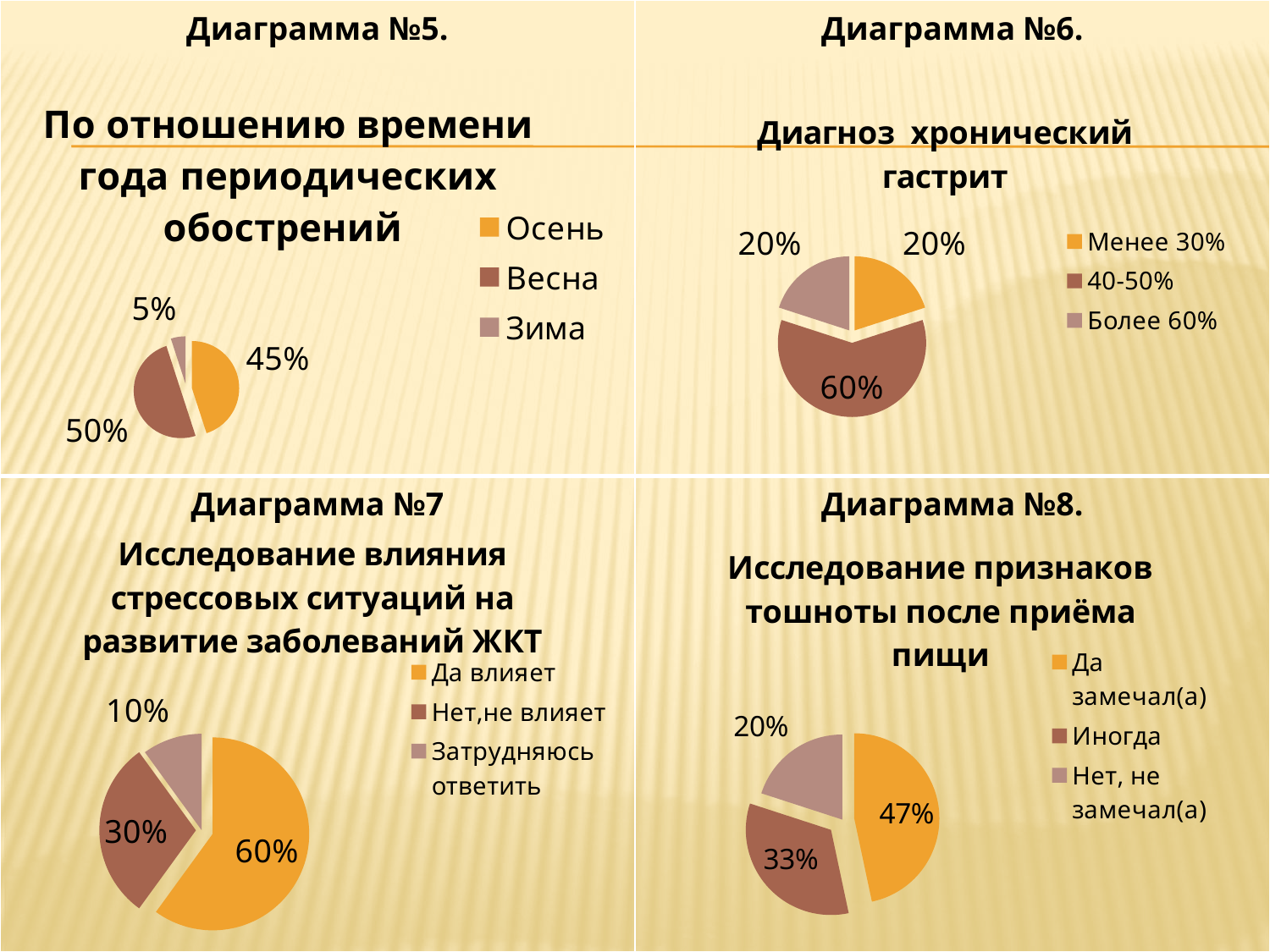
In Диаграмма №5, which category has the smallest slice? Зима In Диаграмма №7, which is larger: Да влияет or Затрудняюсь ответить? Да влияет In Диаграмма №6, what share of the pie is labelled 40-50%? 60% In Диаграмма №7, what is the difference between the Да влияет and Нет,не влияет slices? 30% In Диаграмма №5, what is the difference between the Весна and Осень slices? 5% In Диаграмма №8, which category has the largest slice? Да замечал(а) What type of chart is Диаграмма №8? Pie chart In Диаграмма №6, which category has the largest slice? 40-50% In Диаграмма №6, how many slices does the pie have? 3 In Диаграмма №7, what share of the pie is labelled Нет,не влияет? 30% In Диаграмма №8, what share of the pie is labelled Иногда? 33% In Диаграмма №5, what share of the pie is labelled Весна? 50%